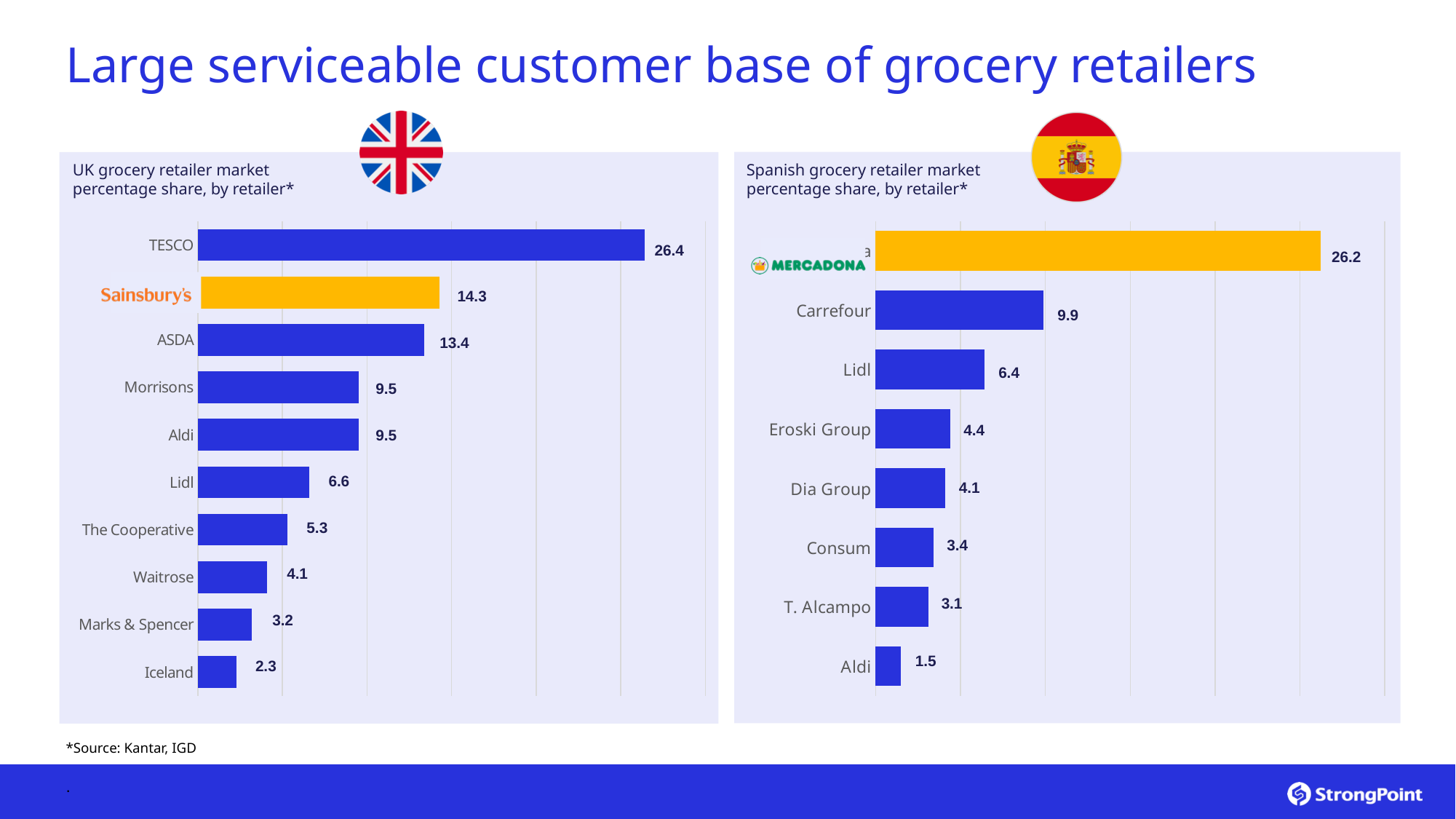
In the Spanish grocery retailer market share chart, what is the difference between Carrefour and Lidl? 3.5 In the UK grocery retailer market share chart, what is the value for TESCO? 26.4 In the Spanish grocery retailer market share chart, how many retailers are shown? 8 In the UK grocery retailer market share chart, what is the value for Sainsbury's? 14.3 In the Spanish grocery retailer market share chart, what is the value for Aldi? 1.5 In the UK grocery retailer market share chart, how many retailers are shown? 10 In the UK grocery retailer market share chart, which retailer has the lowest share? Iceland In the Spanish grocery retailer market share chart, which is larger, Lidl or Eroski Group? Lidl In the Spanish grocery retailer market share chart, what is the value for Carrefour? 9.9 What type of chart is used on the slide for the UK grocery retailer market share? Bar chart In the UK grocery retailer market share chart, what is the difference between TESCO and ASDA? 13.0 In the Spanish grocery retailer market share chart, which retailer has the highest share? Mercadona